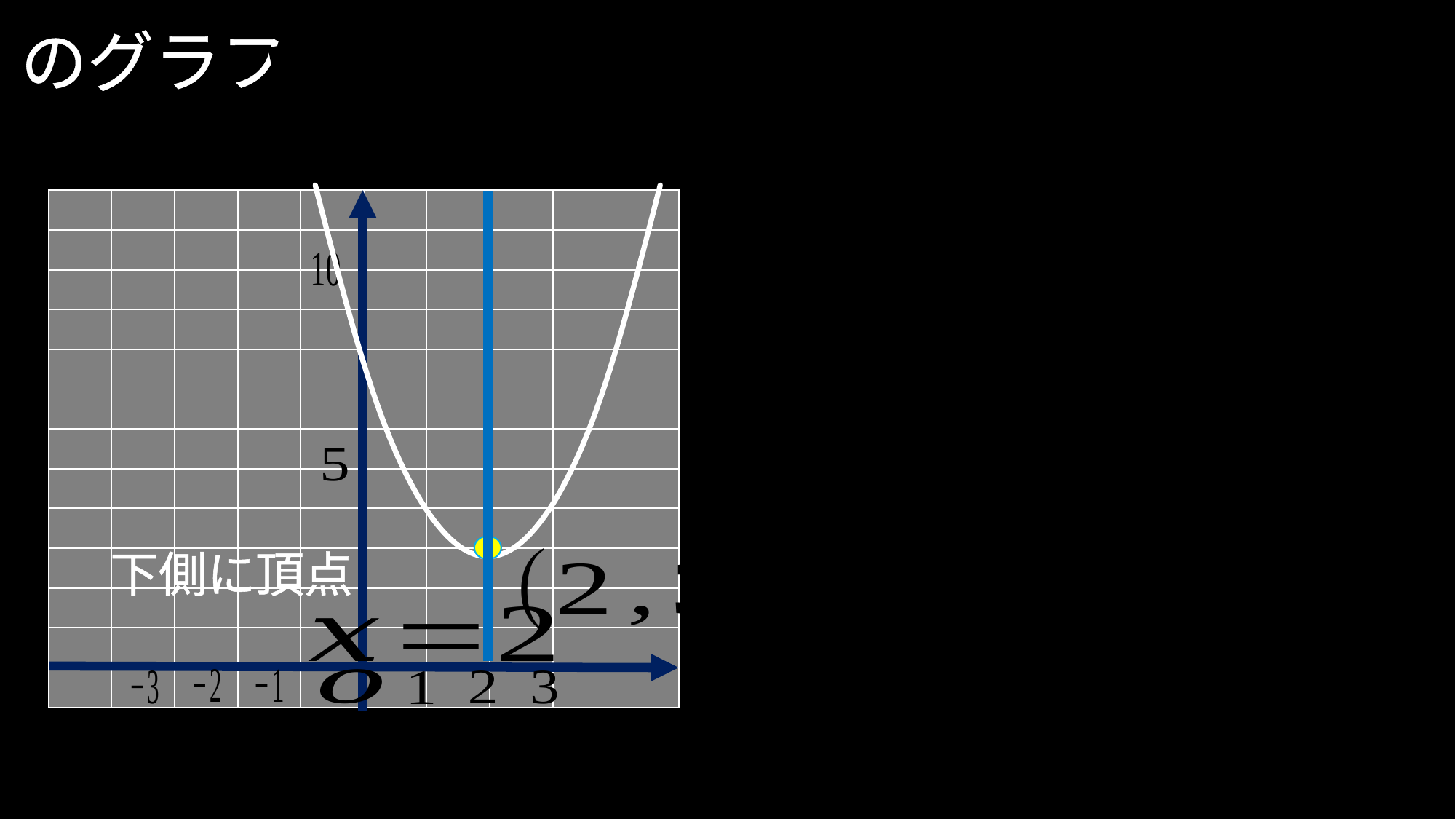
What is the smallest x-axis label shown? -3 Is the y-value of the parabola's vertex greater or less than 5? less Is the y-value of the parabola at x = 0 greater or less than 5? greater Which is larger, the y-value of the curve at x = 1 or at x = 2? x = 1 Which numeric labels are shown on the y-axis? 5 and 10 Is the y-value of the parabola at x = 0 greater or less than 10? less Moving from x = 0 to x = 2, does the curve rise or fall? fall What is the x-coordinate of the vertex of the parabola? 2 What equation is written for the vertical line drawn through the vertex of the parabola? x = 2 Does the parabola open upward or downward? upward How many numbered tick labels are shown on the x-axis (excluding O)? 6 Moving from x = 2 to x = 3, does the curve rise or fall? rise